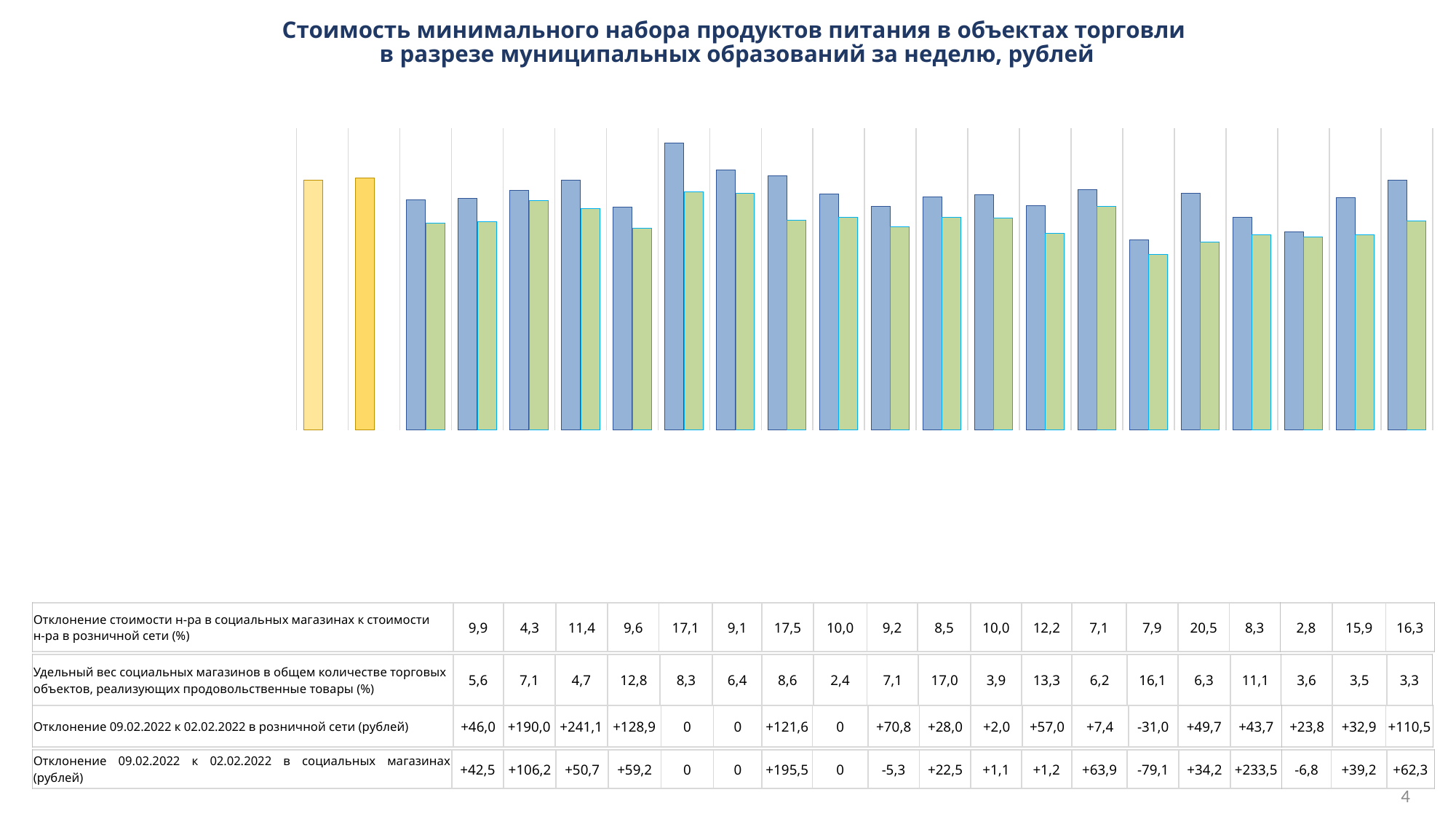
What colour are the two leftmost bars in the chart? yellow What is the title of the chart? Стоимость минимального набора продуктов питания в объектах торговли в разрезе муниципальных образований за неделю, рублей In the paired bars of the chart, are the blue bars generally taller or shorter than the green bars next to them? taller What kind of chart is shown on the slide? bar chart